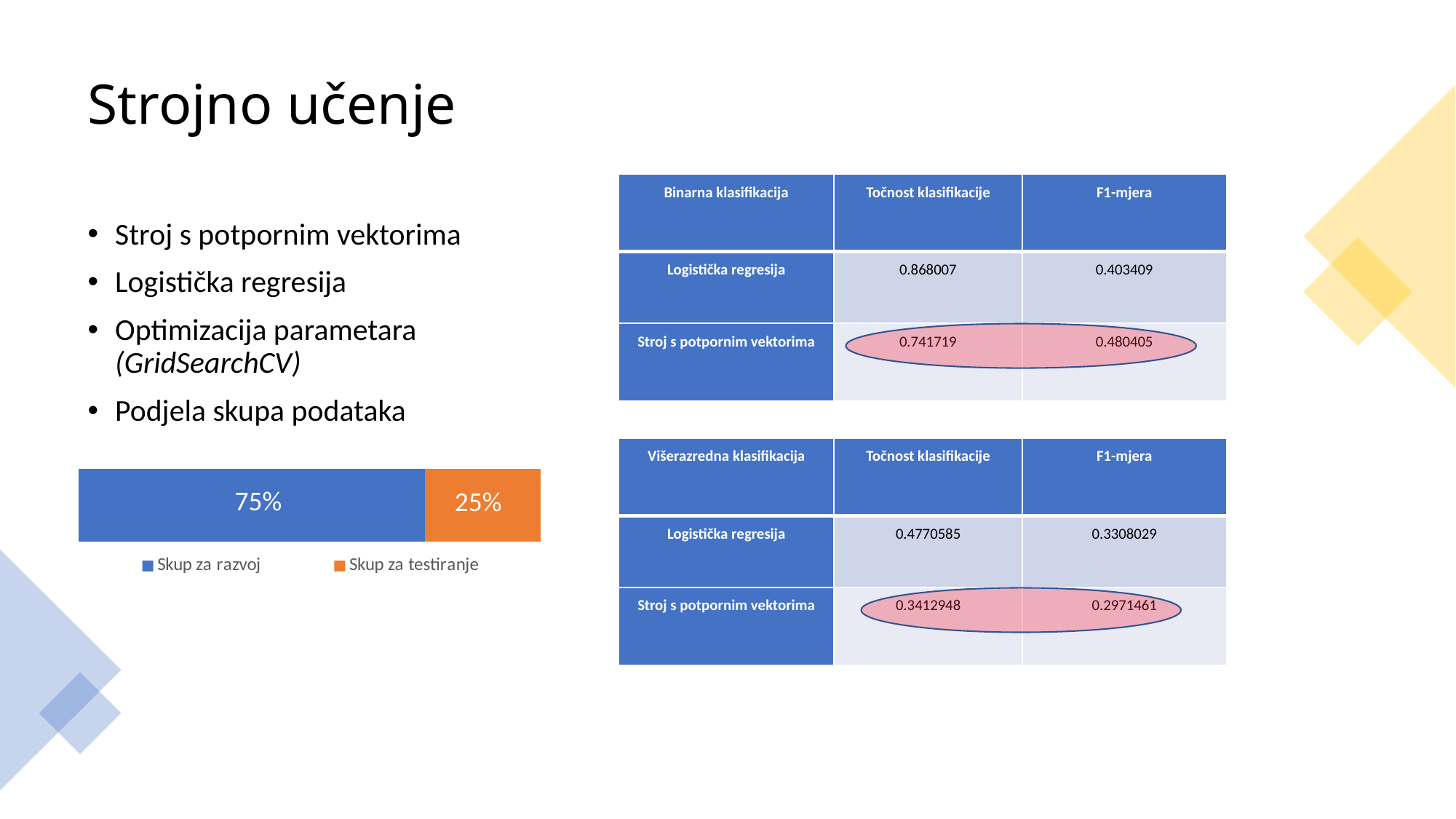
What is the difference between the Skup za razvoj and Skup za testiranje values in the bar chart? 50% What colour is the Skup za razvoj segment in the bar chart? Blue What is the total of the two segments in the stacked bar? 100% Which series has the largest value in the bar chart? Skup za razvoj Which series has the larger share in the bar chart, Skup za razvoj or Skup za testiranje? Skup za razvoj What value is shown for Skup za razvoj in the bar chart? 75% Which series has the smallest value in the bar chart? Skup za testiranje What kind of chart is shown on the left of the slide? Stacked bar chart What value is shown for Skup za testiranje in the bar chart? 25% What colour is the Skup za testiranje segment in the bar chart? Orange How many series does the legend of the bar chart list? 2